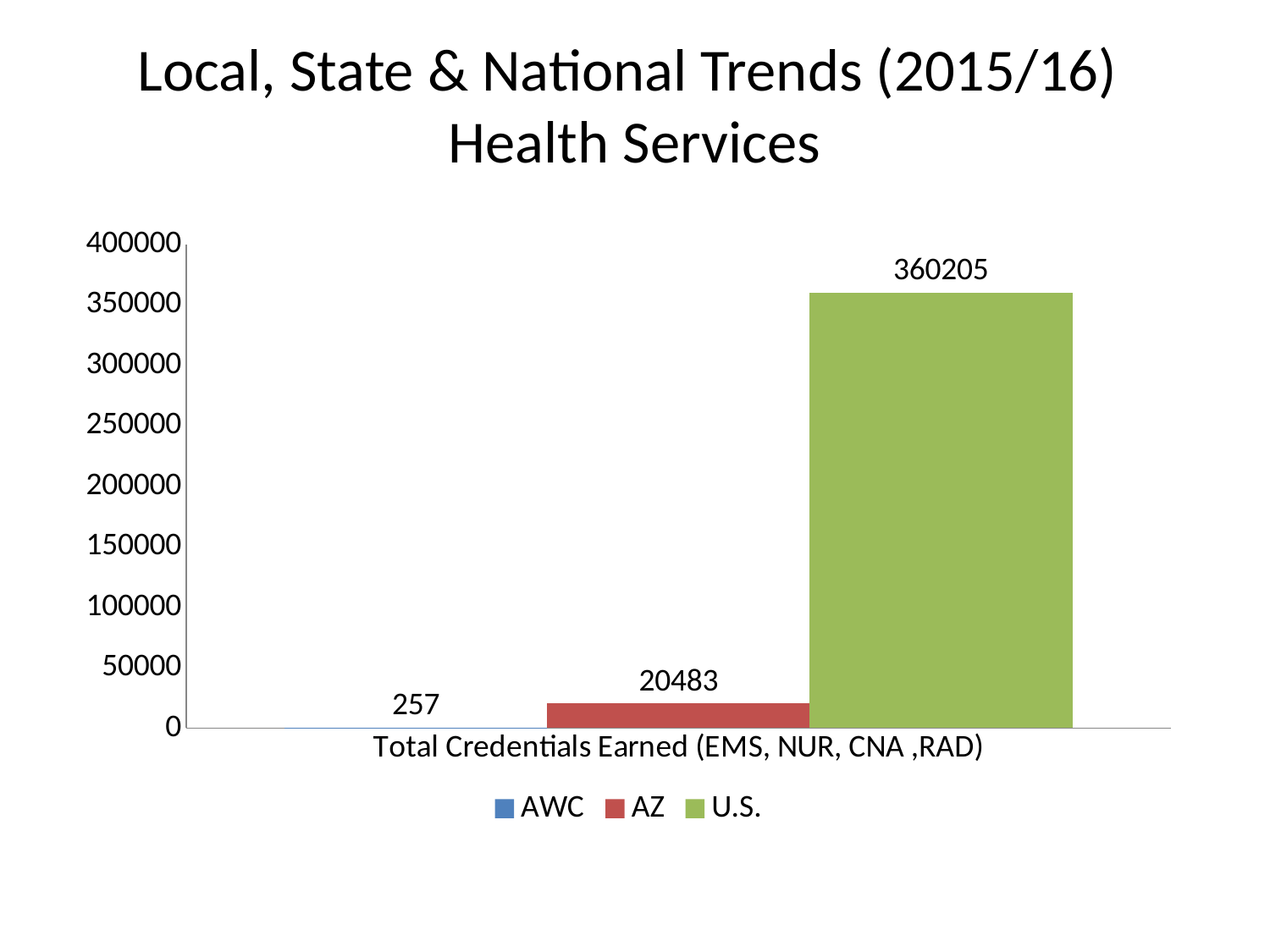
Is the value for U.S. greater or less than 350000? greater What is the difference between the AZ value and the AWC value? 20226 What is the difference between the U.S. value and the AZ value? 339722 What is the title of the slide? Local, State & National Trends (2015/16) Health Services How many series does the legend list? 3 What kind of chart is shown on the slide? Bar chart Which series has the highest value for Total Credentials Earned? U.S. Which series has the lowest value for Total Credentials Earned? AWC Which is larger, the value for AZ or the value for AWC? AZ What is the value for AZ in Total Credentials Earned (EMS, NUR, CNA, RAD)? 20483 What is the value for AWC in Total Credentials Earned (EMS, NUR, CNA, RAD)? 257 What is the value for U.S. in Total Credentials Earned (EMS, NUR, CNA, RAD)? 360205